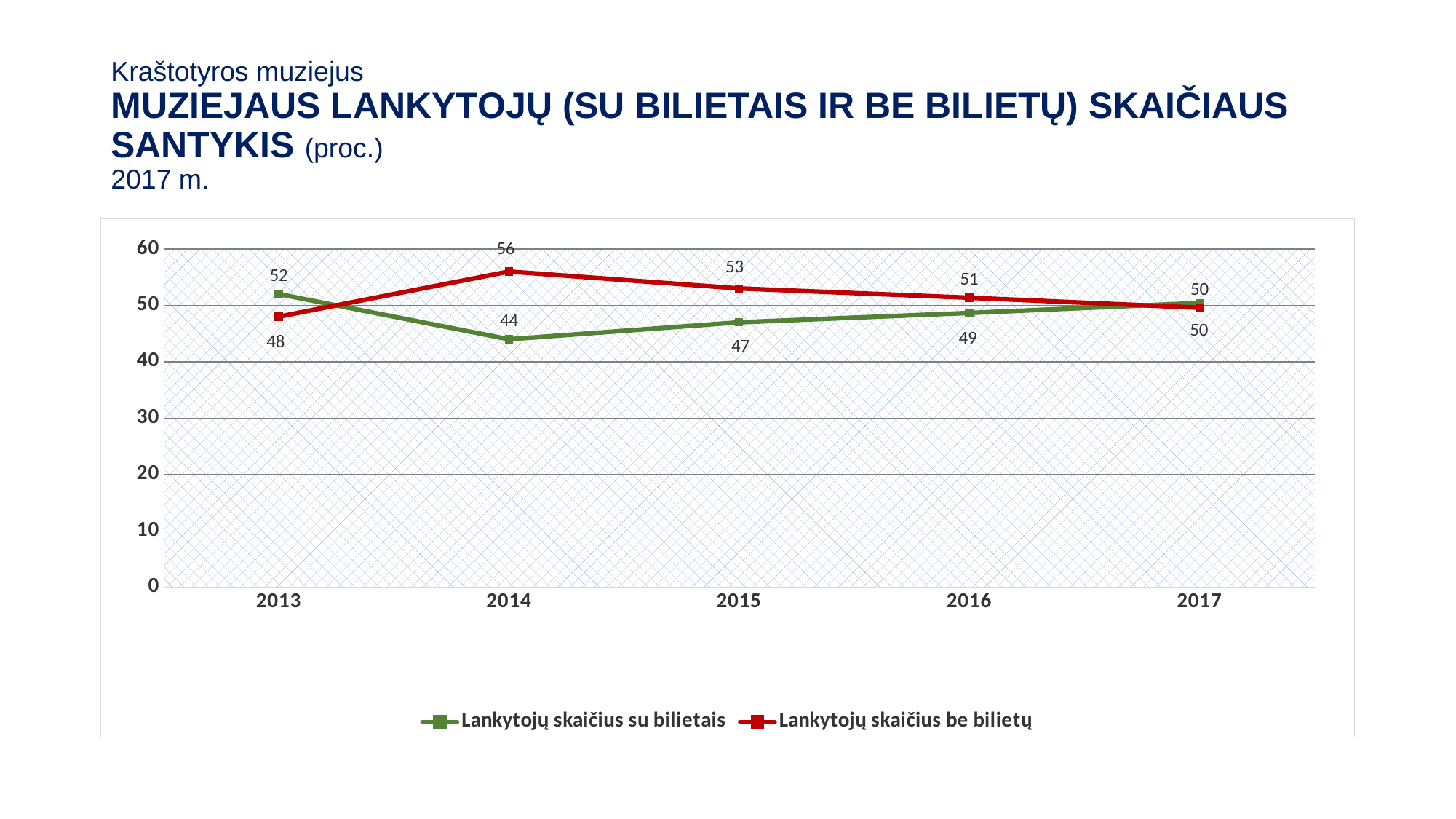
What is the difference between 'Lankytojų skaičius be bilietų' and 'Lankytojų skaičius su bilietais' in 2014? 12 Is the value for 'Lankytojų skaičius su bilietais' in 2015 greater or less than 50? less In which year is 'Lankytojų skaičius su bilietais' lowest? 2014 Which series has the larger value in 2013, 'Lankytojų skaičius su bilietais' or 'Lankytojų skaičius be bilietų'? Lankytojų skaičius su bilietais What is the value for 'Lankytojų skaičius su bilietais' in 2014? 44 Does 'Lankytojų skaičius be bilietų' rise or fall from 2014 to 2017? fall What is the value for 'Lankytojų skaičius be bilietų' in 2016? 51 What is the value for 'Lankytojų skaičius be bilietų' in 2013? 48 How many series does the legend list? 2 In which year is 'Lankytojų skaičius be bilietų' highest? 2014 How many years are shown on the x axis? 5 What kind of chart is shown on the slide? line chart